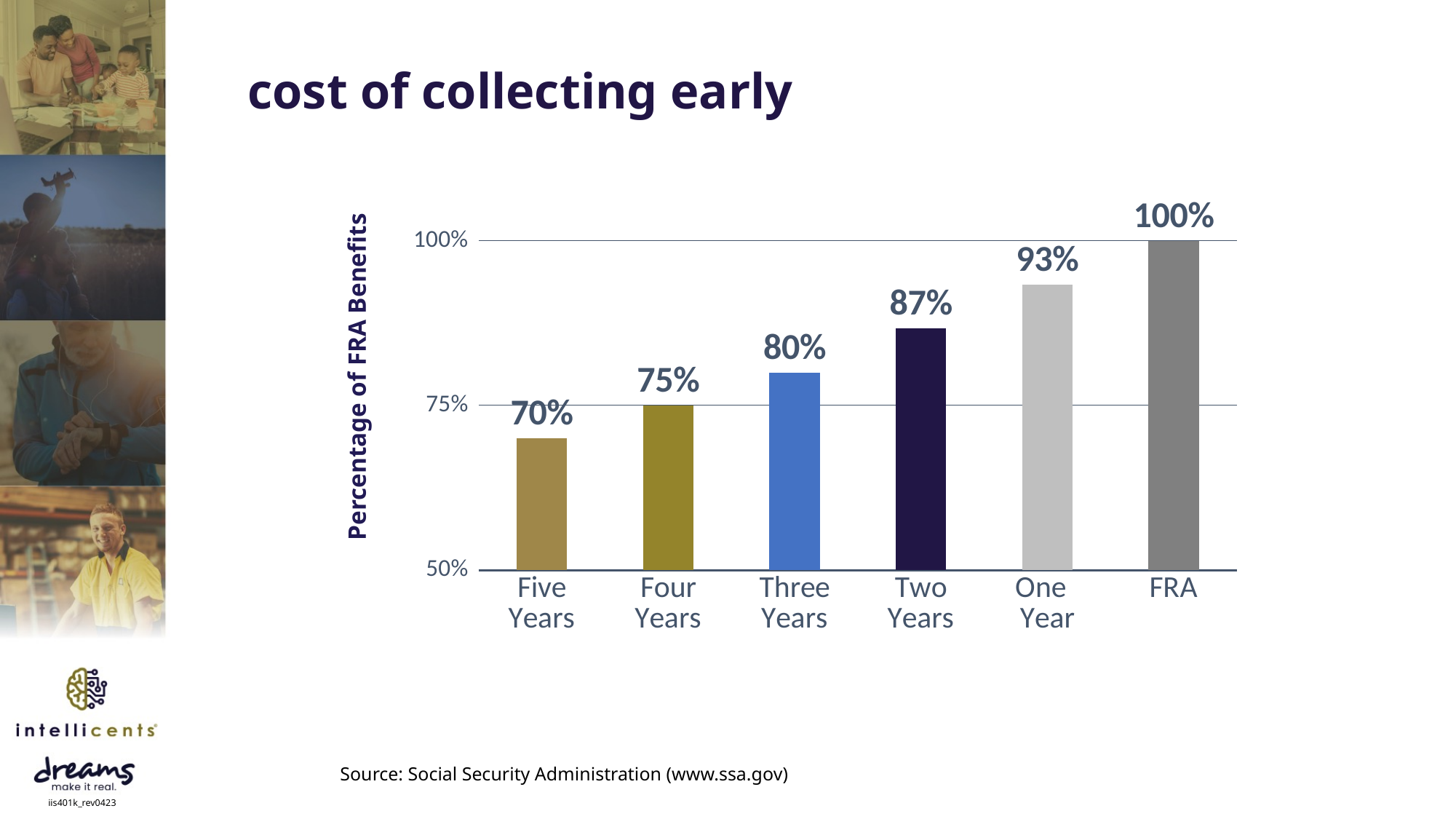
What percentage of FRA benefits is shown for collecting One Year early? 93% What kind of chart is shown on the slide? bar chart What percentage of FRA benefits is shown for collecting Five Years early? 70% What is the difference in percentage of FRA benefits between Three Years and Four Years? 5% What percentage of FRA benefits is shown for collecting Two Years early? 87% Do the values rise or fall moving from Five Years to FRA along the x axis? rise Which has a higher percentage of FRA benefits, Two Years or Three Years? Two Years What is the difference in percentage of FRA benefits between FRA and Five Years? 30% How many categories are shown on the x axis of the chart? 6 Is the value for Four Years greater or less than 100%? less Which category has the highest percentage of FRA benefits? FRA Which category has the lowest percentage of FRA benefits? Five Years